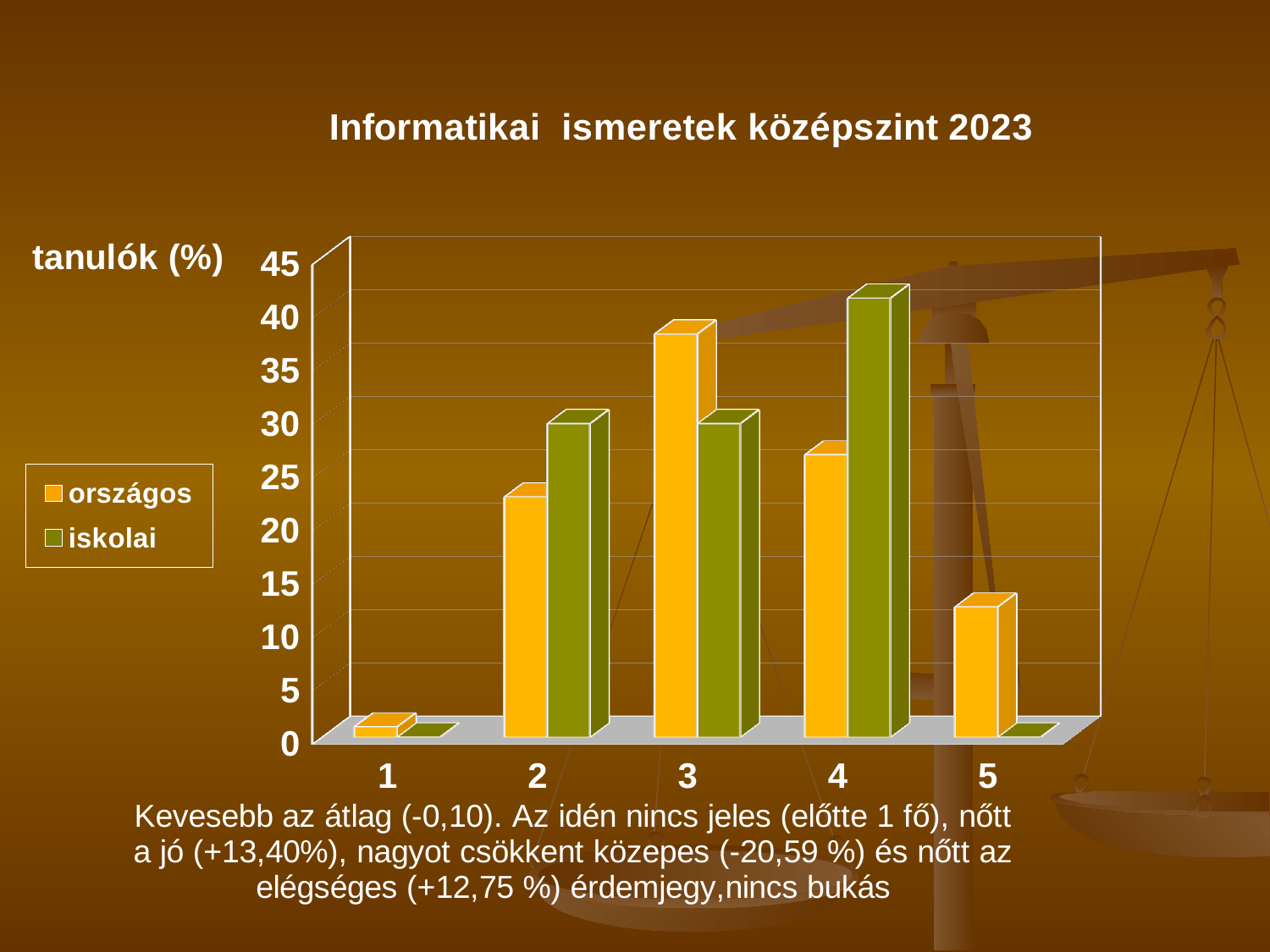
Which category has the highest value for the iskolai series? 4 What kind of chart is shown on the slide? bar chart How many categories are shown on the x axis? 5 Which category has the lowest value for the országos series? 1 Is the iskolai value for category 4 greater or less than 35? greater What label is shown on the vertical axis? tanulók (%) How many series does the legend list? 2 Is the országos value for category 3 greater or less than 35? greater For category 3, which series has the larger value, országos or iskolai? országos For category 4, which series has the larger value, országos or iskolai? iskolai What is the title of the chart? Informatikai ismeretek középszint 2023 Which category has the highest value for the országos series? 3